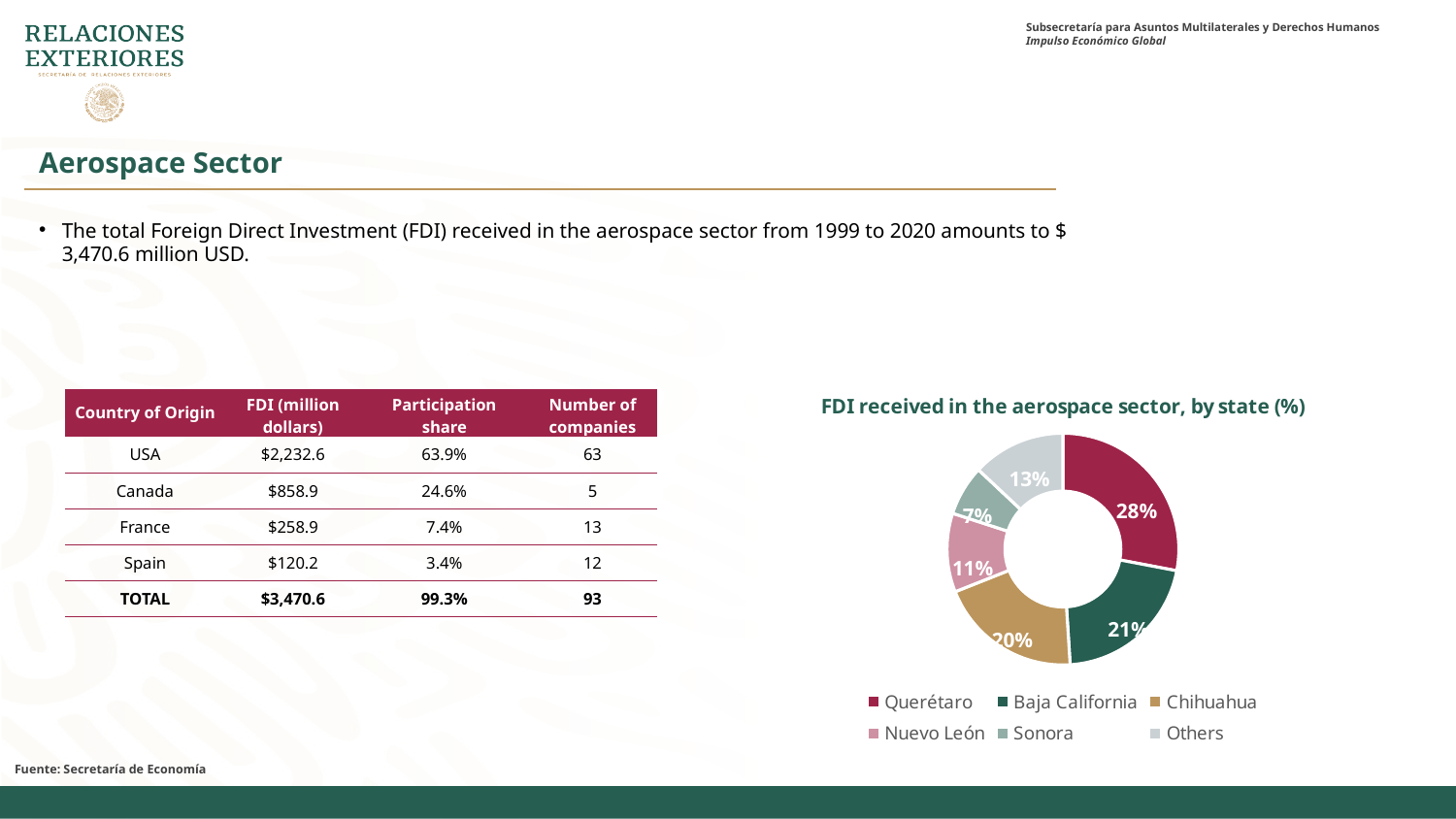
How many slices does the doughnut chart have? 6 What share of aerospace FDI is attributed to Nuevo León? 11% What percentage does the 'Others' slice represent? 13% What type of chart is used to show FDI received in the aerospace sector by state? Doughnut chart Which has a larger share of aerospace FDI, Chihuahua or Nuevo León? Chihuahua What share of FDI received in the aerospace sector does Querétaro account for? 28% What is the value shown for Chihuahua in the doughnut chart? 20% What percentage of aerospace FDI is shown for Baja California? 21% Which legend entry has the smallest slice in the chart? Sonora Which state has the largest share of FDI received in the aerospace sector? Querétaro What is the title of the chart on the slide? FDI received in the aerospace sector, by state (%) How many percentage points larger is Querétaro's share than Baja California's? 7